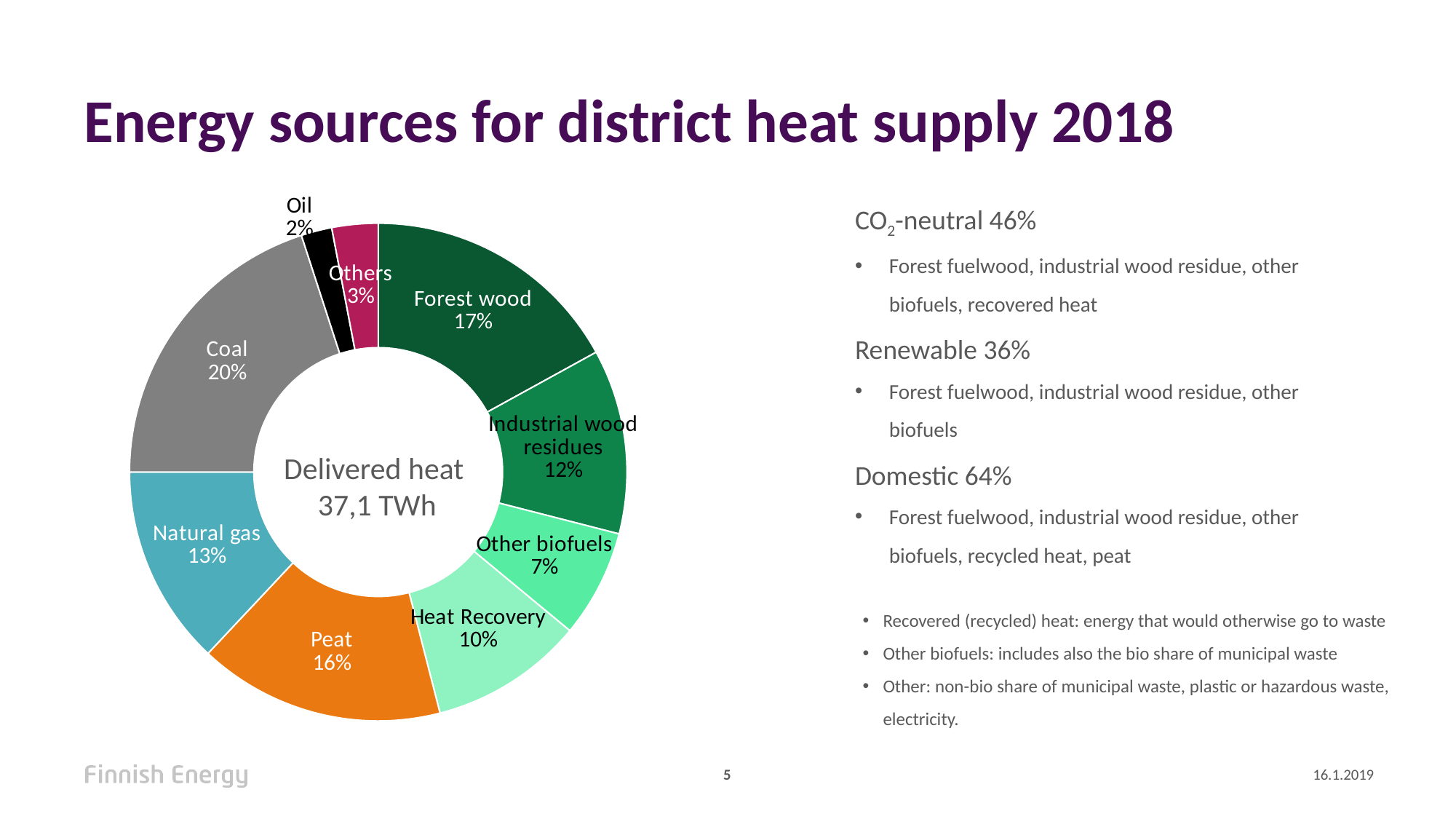
What share of district heat supply comes from Forest wood? 17% What colour is the Peat slice in the chart? Orange Which energy source has the largest share in the chart? Coal How many energy source categories are shown in the chart? 9 What kind of chart is shown on the slide? Pie chart (doughnut) Which energy source has the smallest share in the chart? Oil What share of district heat supply comes from Peat? 16% Which has a larger share, Industrial wood residues or Other biofuels? Industrial wood residues What is the combined share of Forest wood and Industrial wood residues? 29% What total delivered heat is shown in the centre of the chart? 37,1 TWh What is the difference in percentage points between Coal and Natural gas? 7 What share of district heat supply comes from Heat Recovery? 10%